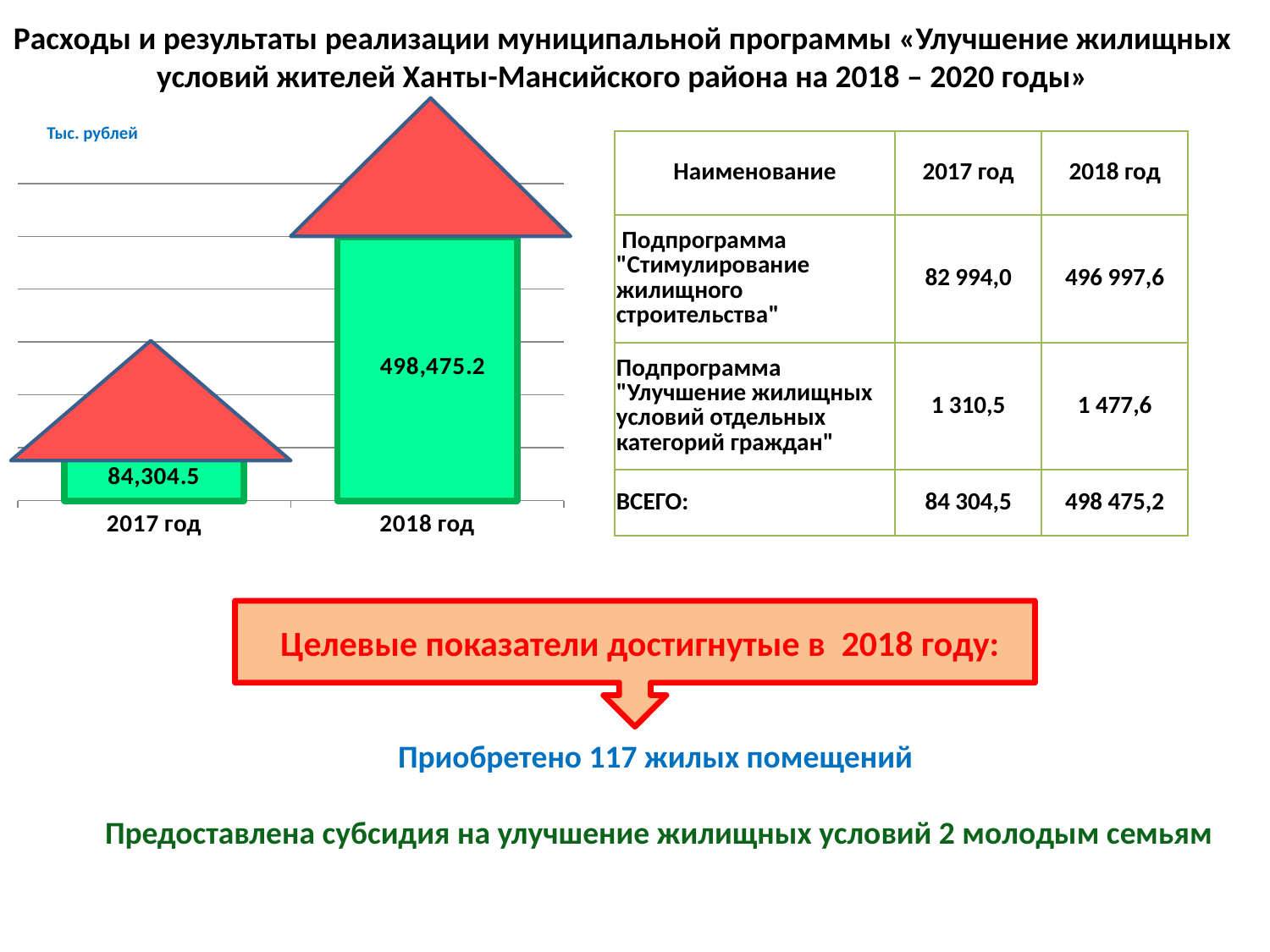
What colour are the bars on the bar chart? green What kind of chart is shown on the left of the slide? bar chart What is the value shown for 2018 год on the bar chart? 498,475.2 Is the value for 2018 год larger or smaller than the value for 2017 год on the bar chart? larger How many categories (years) are plotted on the bar chart? 2 Do the values on the bar chart rise or fall from 2017 год to 2018 год? rise By how much does the value for 2018 год exceed the value for 2017 год on the bar chart? 414,170.7 Which year has the lower value on the bar chart? 2017 год Which year has the higher value on the bar chart? 2018 год What unit is indicated for the values on the bar chart? Тыс. рублей What is the value shown for 2017 год on the bar chart? 84,304.5